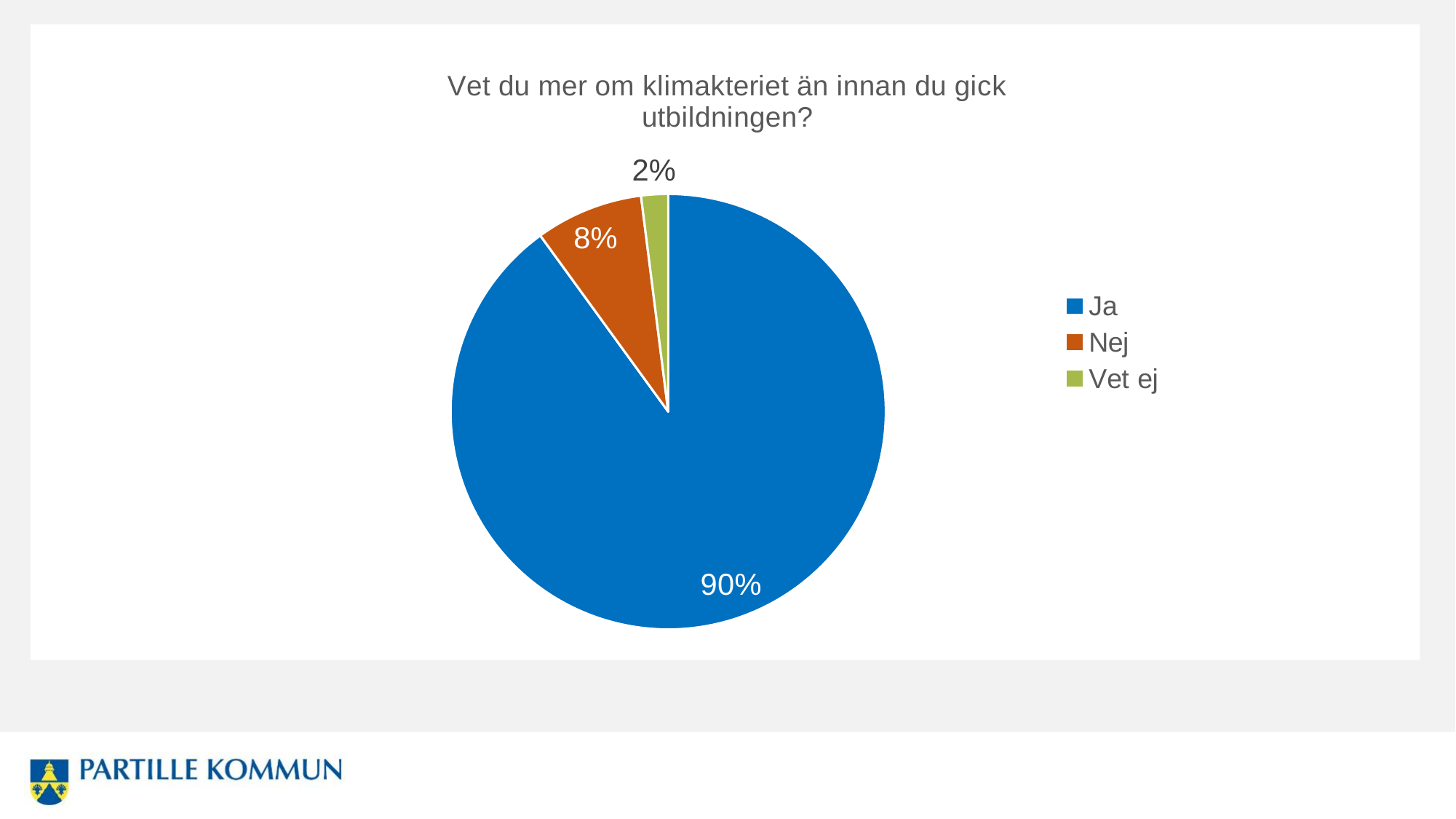
What colour is the slice for "Nej"? orange What percentage of respondents answered "Vet ej"? 2% What is the difference in percentage points between "Ja" and "Nej"? 82 Which answer has the largest share of the pie? Ja What type of chart is shown on the slide? pie chart How many entries does the legend list? 3 What is the title of the chart? Vet du mer om klimakteriet än innan du gick utbildningen? What percentage of respondents answered "Ja"? 90% How many slices does the pie chart have? 3 Which is larger, the share for "Nej" or the share for "Vet ej"? Nej What percentage of respondents answered "Nej"? 8% Which answer has the smallest share of the pie? Vet ej